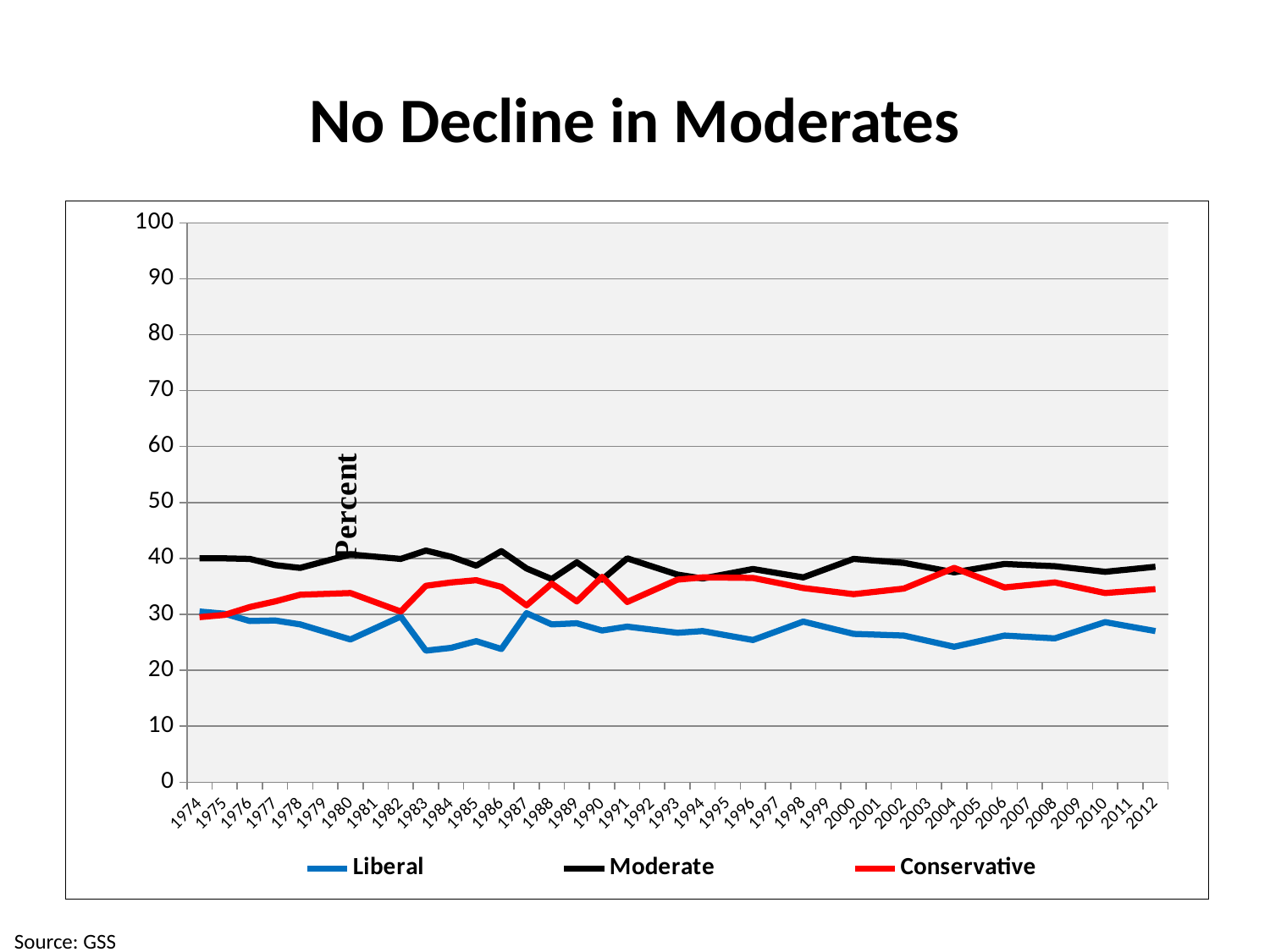
Is the value for Liberal in 2004 greater or less than 30? less How many years are labelled along the x axis? 39 Which series has the highest value in 1974? Moderate How many series does the legend list? 3 What kind of chart is shown on the slide? line chart Is the value for Liberal in 1984 greater or less than 30? less What colour is the Conservative line? red In 1974, which is larger, the Moderate value or the Liberal value? Moderate What is the title of the chart? No Decline in Moderates Is the value for Conservative in 2012 greater or less than 30? greater In 1991, which is larger, the Moderate value or the Conservative value? Moderate